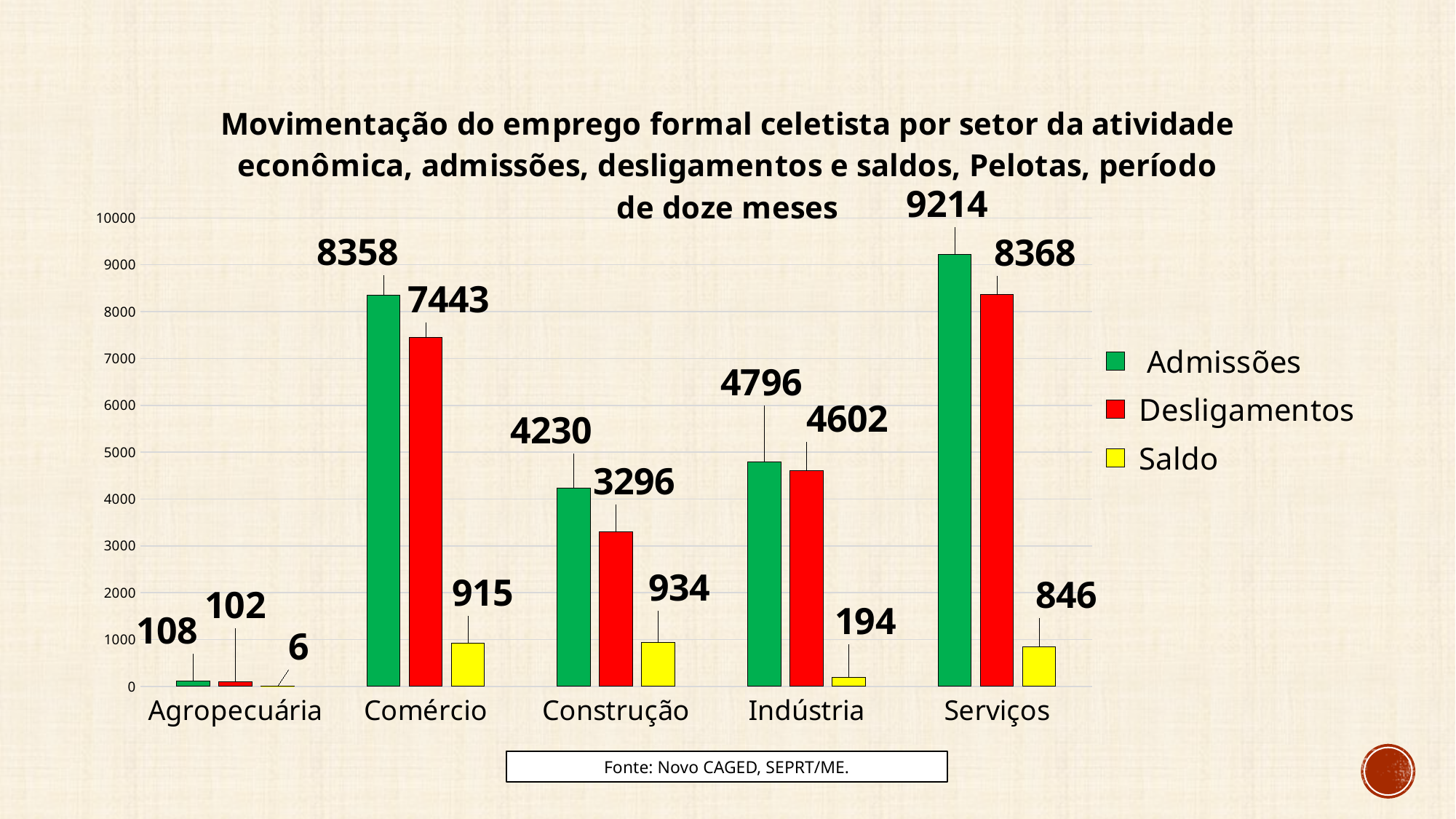
What is the Saldo value for Construção? 934 How many series does the legend list? 3 What is the difference between Admissões and Desligamentos for Serviços? 846 How many sectors are shown on the x axis? 5 What is the value of Admissões for Comércio? 8358 What colour represents the Saldo series in the legend? yellow What kind of chart is shown on the slide? bar chart Which sector has the highest Admissões value? Serviços Which sector has the lowest Saldo value? Agropecuária Is the Admissões value for Indústria greater or less than 4000? greater What is the value of Desligamentos for Indústria? 4602 Which is larger for Construção: Admissões or Desligamentos? Admissões